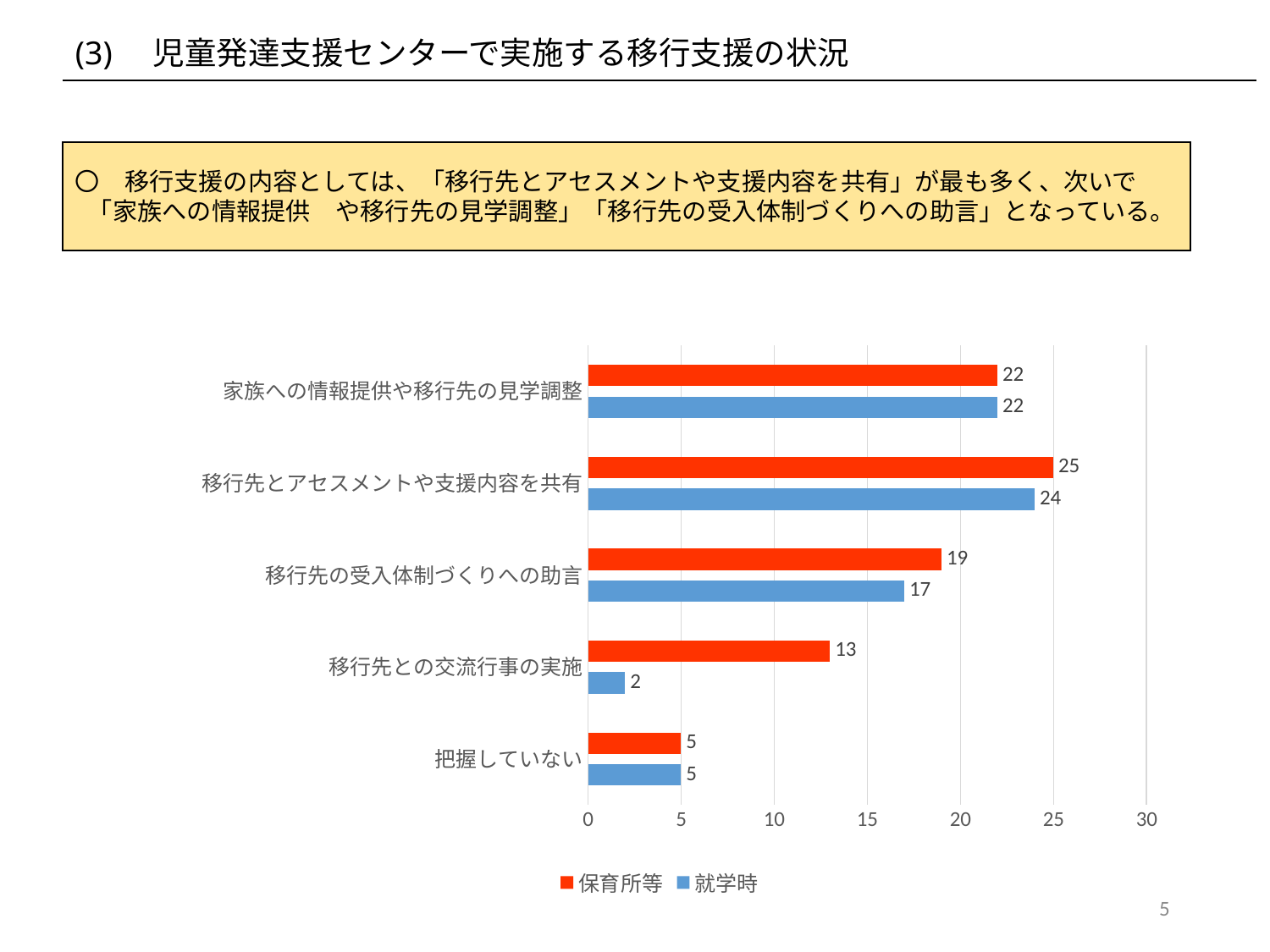
Is the 保育所等 value for 移行先との交流行事の実施 greater or less than 10? greater How many series does the legend list? 2 What kind of chart is shown on the slide? Bar chart Which category has the highest value for the 保育所等 series? 移行先とアセスメントや支援内容を共有 Which is larger for 移行先の受入体制づくりへの助言: the 保育所等 value or the 就学時 value? 保育所等 What is the difference between the 保育所等 and 就学時 values for 移行先との交流行事の実施? 11 What is the value for 就学時 in the category 移行先との交流行事の実施? 2 Which category has the lowest value for the 就学時 series? 移行先との交流行事の実施 How many categories are shown on the chart? 5 What is the value for 就学時 in the category 移行先の受入体制づくりへの助言? 17 Which colour represents the 就学時 series? Blue What is the value for 保育所等 in the category 移行先とアセスメントや支援内容を共有? 25